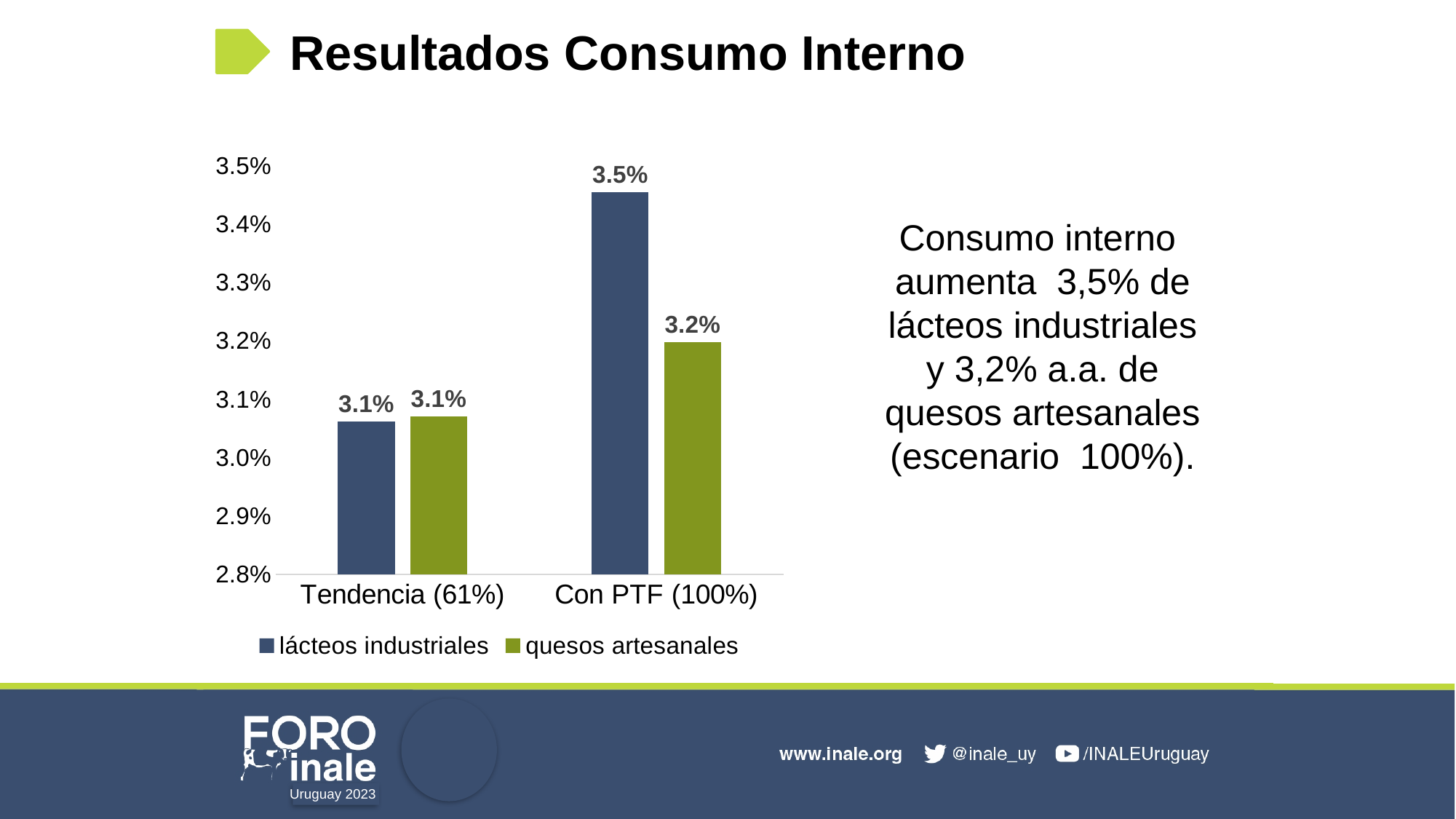
What is the value for lácteos industriales in the Con PTF (100%) scenario? 3.5% How many series does the legend list? 2 In the Con PTF (100%) scenario, which is larger: lácteos industriales or quesos artesanales? lácteos industriales Which series is shown in green in the legend? quesos artesanales Which bar has the highest value in the chart? lácteos industriales, Con PTF (100%) What is the value for quesos artesanales in the Tendencia (61%) scenario? 3.1% What is the value for lácteos industriales in the Tendencia (61%) scenario? 3.1% What is the value for quesos artesanales in the Con PTF (100%) scenario? 3.2% What is the difference between lácteos industriales and quesos artesanales in the Con PTF (100%) scenario? 0.3% How many categories are shown on the x axis? 2 Is the value for lácteos industriales in the Con PTF (100%) scenario greater or less than 3.4%? greater What type of chart is shown on the slide? bar chart